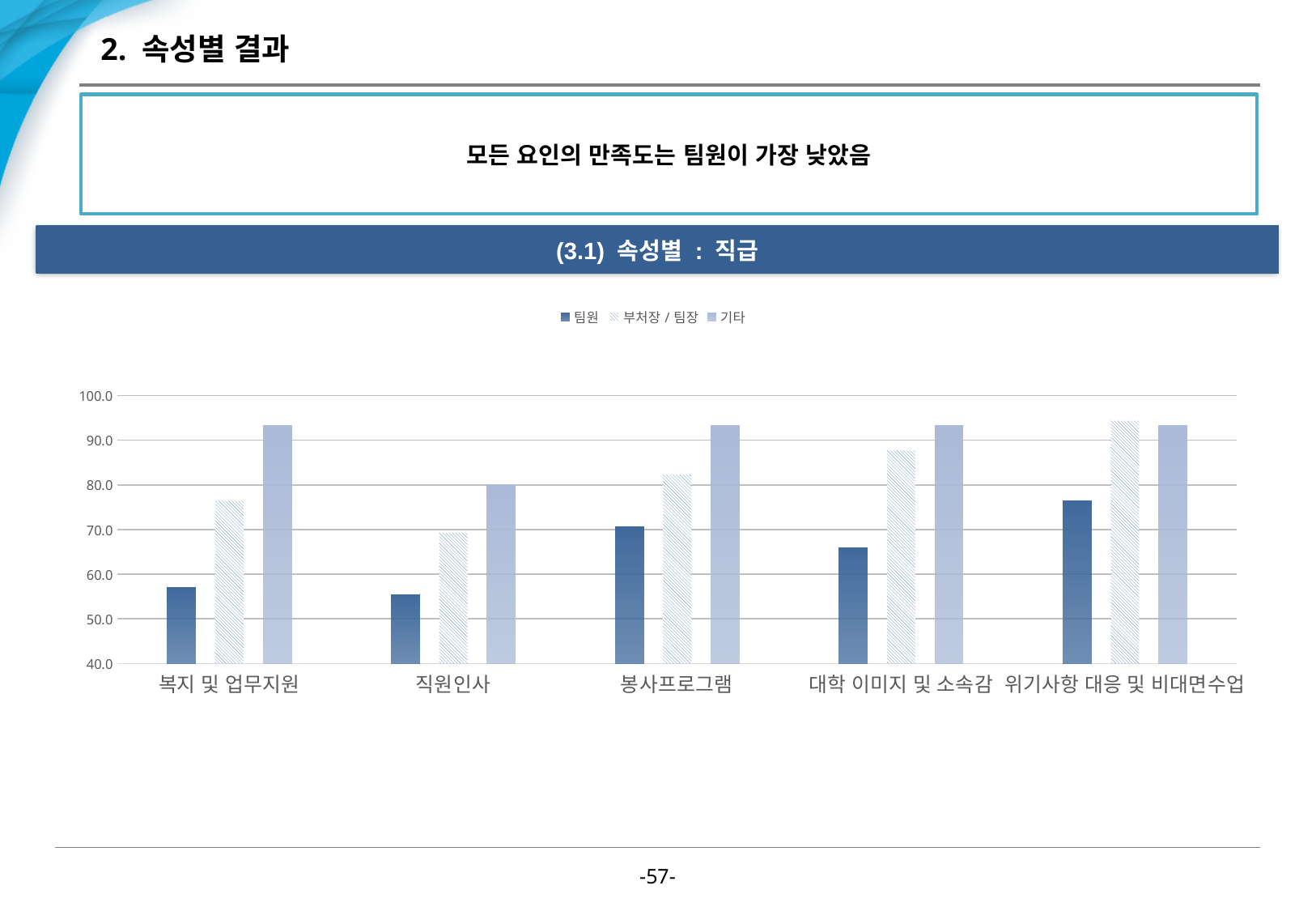
For the 팀원 series, which category has the highest value? 위기사항 대응 및 비대면수업 Is the value for 팀원 in 대학 이미지 및 소속감 greater or less than 70? less For the 부처장 / 팀장 series, which category has the lowest value? 직원인사 How many categories are shown on the x axis? 5 Is the value for 부처장 / 팀장 in 위기사항 대응 및 비대면수업 greater or less than 90? greater Which series are listed in the legend? 팀원, 부처장 / 팀장, 기타 Is the value for 팀원 in 복지 및 업무지원 greater or less than 60? less In 직원인사, which is larger: the value for 부처장 / 팀장 or the value for 기타? 기타 What kind of chart is shown on the slide? bar chart In 봉사프로그램, which is larger: the value for 팀원 or the value for 기타? 기타 How many series does the legend list? 3